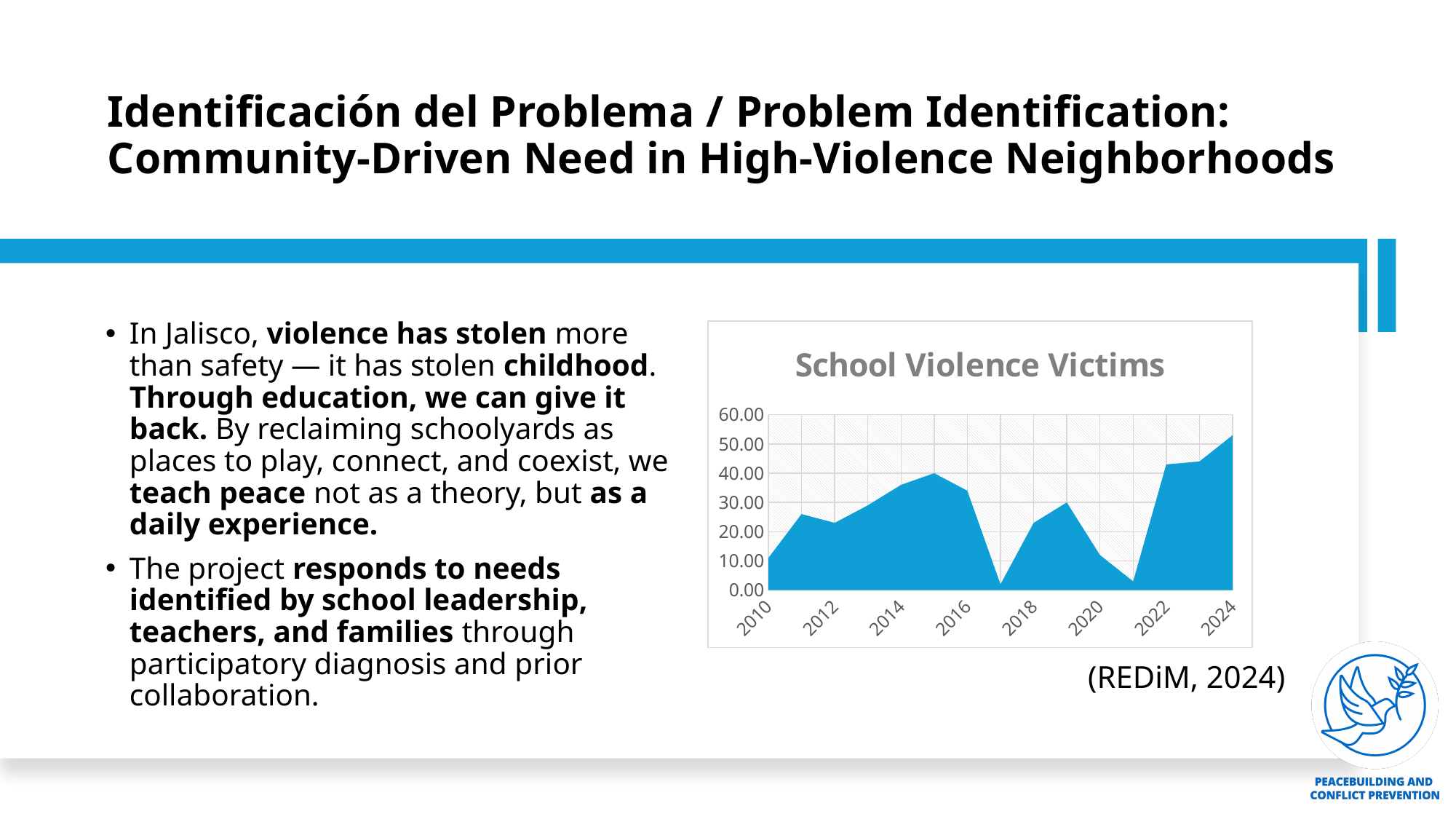
Is the value for 2010 in the School Violence Victims chart greater or less than 20.00? less In the School Violence Victims chart, which year has the larger value, 2010 or 2024? 2024 Is the value for 2024 in the School Violence Victims chart greater or less than 50.00? greater In the School Violence Victims chart, do the values rise or fall from 2022 to 2024? rise Is the value for 2014 in the School Violence Victims chart greater or less than 30.00? greater What kind of chart is shown on the slide? Area chart In the School Violence Victims chart, which year has the larger value, 2012 or 2022? 2022 Which year has the highest value in the School Violence Victims chart? 2024 What source is cited below the School Violence Victims chart? (REDiM, 2024) What is the title of the chart on the slide? School Violence Victims